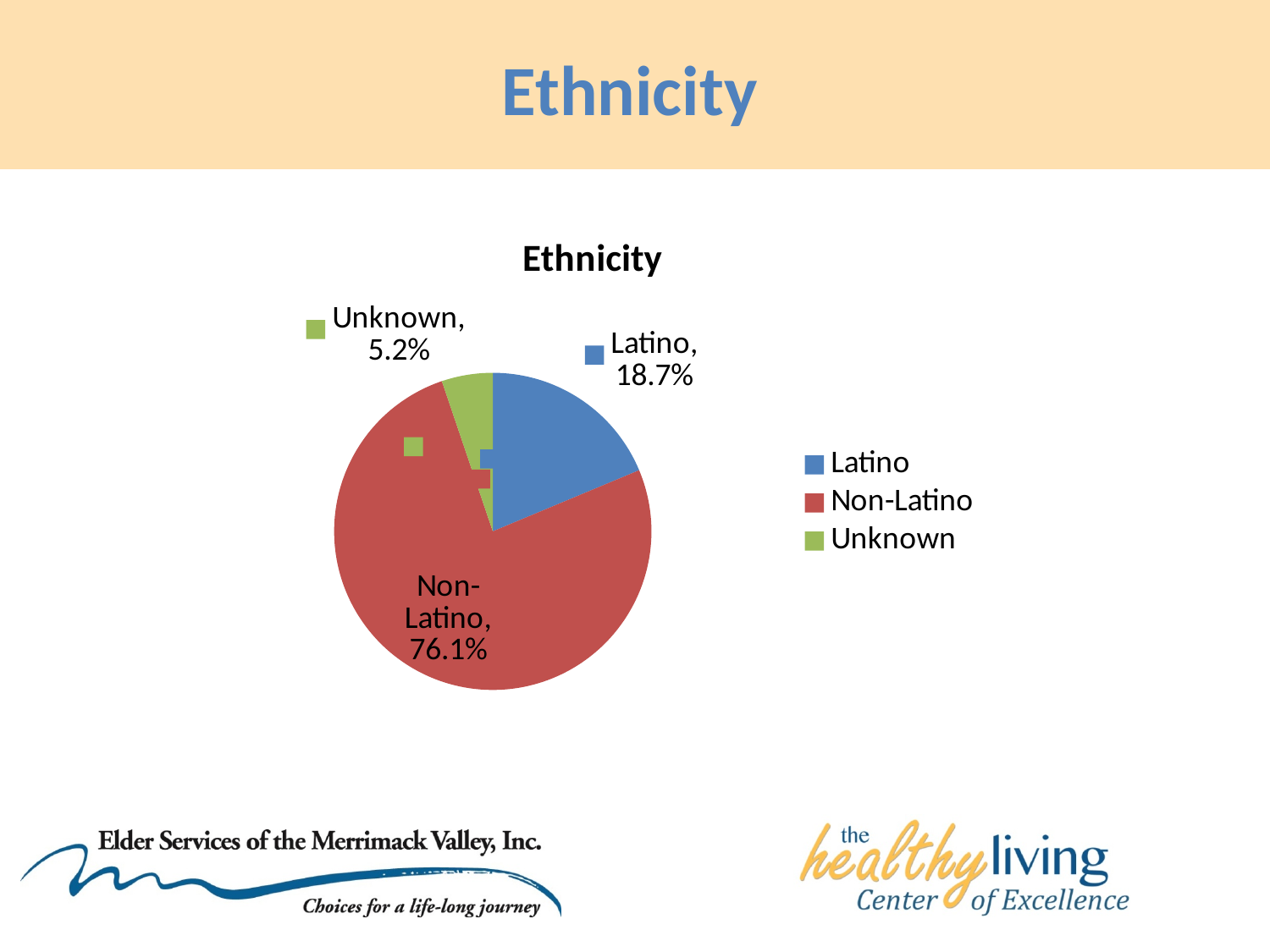
What is the title of the chart? Ethnicity Which category has the largest share of the pie chart? Non-Latino Which is larger, the Latino share or the Unknown share? Latino Which category has the smallest share of the pie chart? Unknown How many categories are shown in the pie chart? 3 What is the difference in percentage points between Non-Latino and Latino? 57.4 What percentage of the pie chart is Latino? 18.7% What kind of chart is shown on the slide? Pie chart What is the difference in percentage points between Latino and Unknown? 13.5 What percentage of the pie chart is Non-Latino? 76.1% How many entries does the legend list? 3 What percentage of the pie chart is Unknown? 5.2%